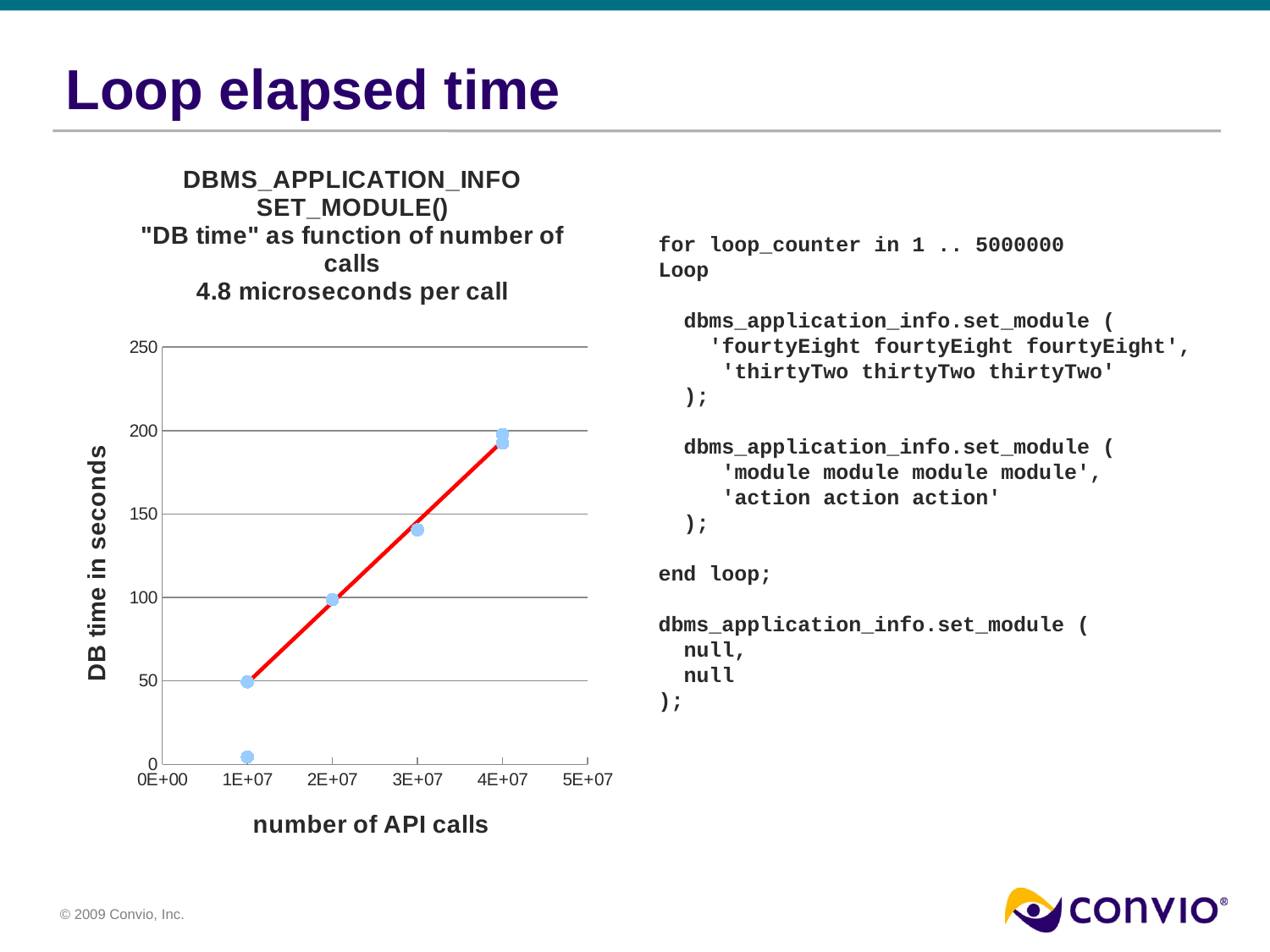
Is the DB time for 2E+07 API calls greater or less than 150 seconds? less Which has the larger DB time: 2E+07 API calls or 4E+07 API calls? 4E+07 According to the chart title, how many microseconds per call does SET_MODULE() take? 4.8 microseconds per call What is the title of the x axis of the chart? number of API calls What kind of chart is shown on the slide? scatter chart Is the DB time for 4E+07 API calls greater or less than 150 seconds? greater Does DB time rise or fall as the number of API calls increases along the x axis? rise Is the DB time for 3E+07 API calls greater or less than 150 seconds? less What is the highest value shown on the y axis of the chart? 250 What is the title of the y axis of the chart? DB time in seconds